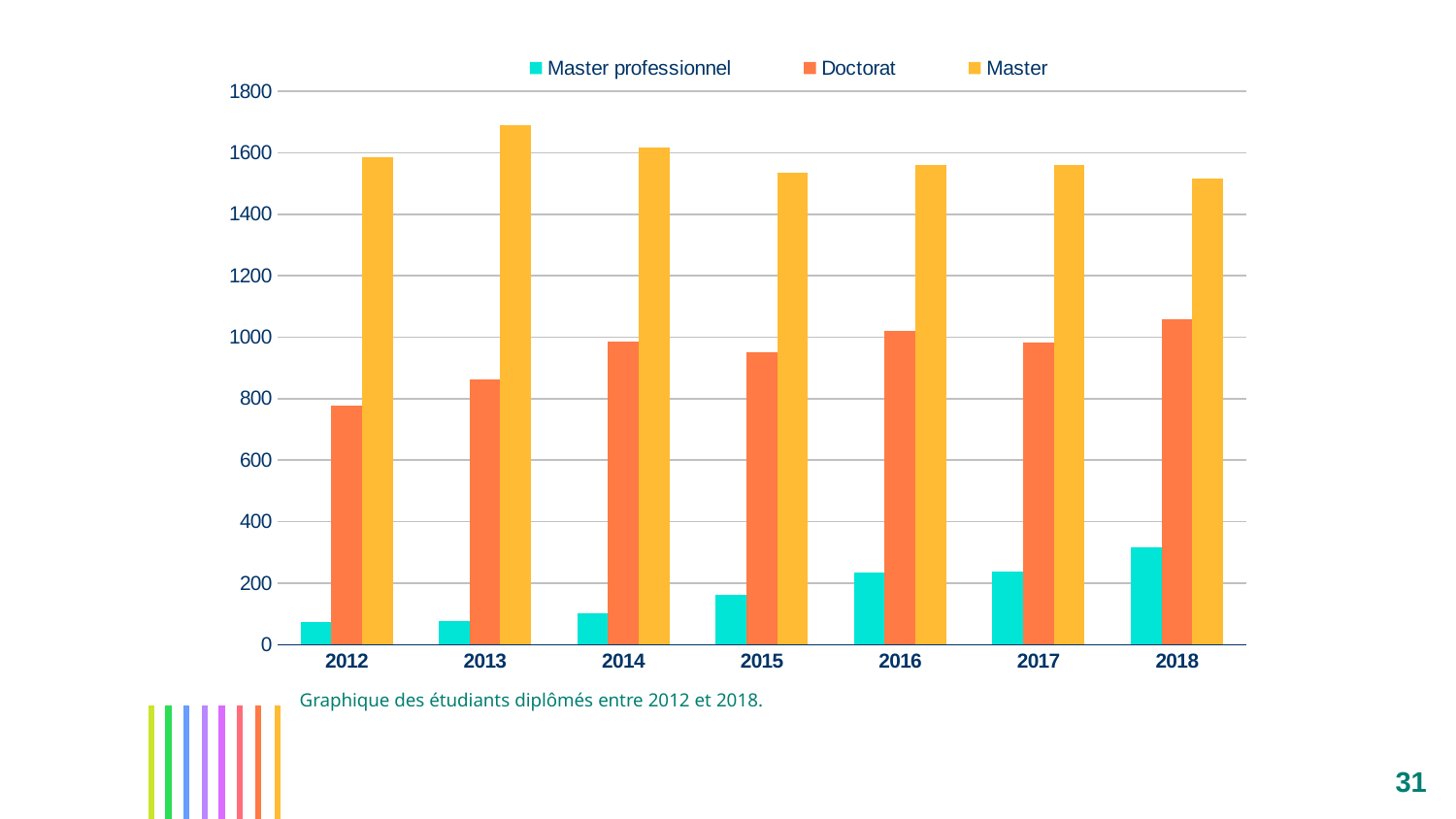
Does the Master professionnel series generally rise or fall from 2012 to 2018? rise How many series does the legend list? 3 Is the Master professionnel value for 2018 greater or less than 200? greater In which year is the Master series highest? 2013 How many years are shown on the x axis? 7 Is the Doctorat value for 2012 greater or less than 800? less Is the Master value for 2013 greater or less than 1600? greater In which year is the Master professionnel series highest? 2018 Which is larger in 2014, the Doctorat value or the Master professionnel value? Doctorat In which year is the Doctorat series lowest? 2012 What kind of chart is shown on the slide? bar chart